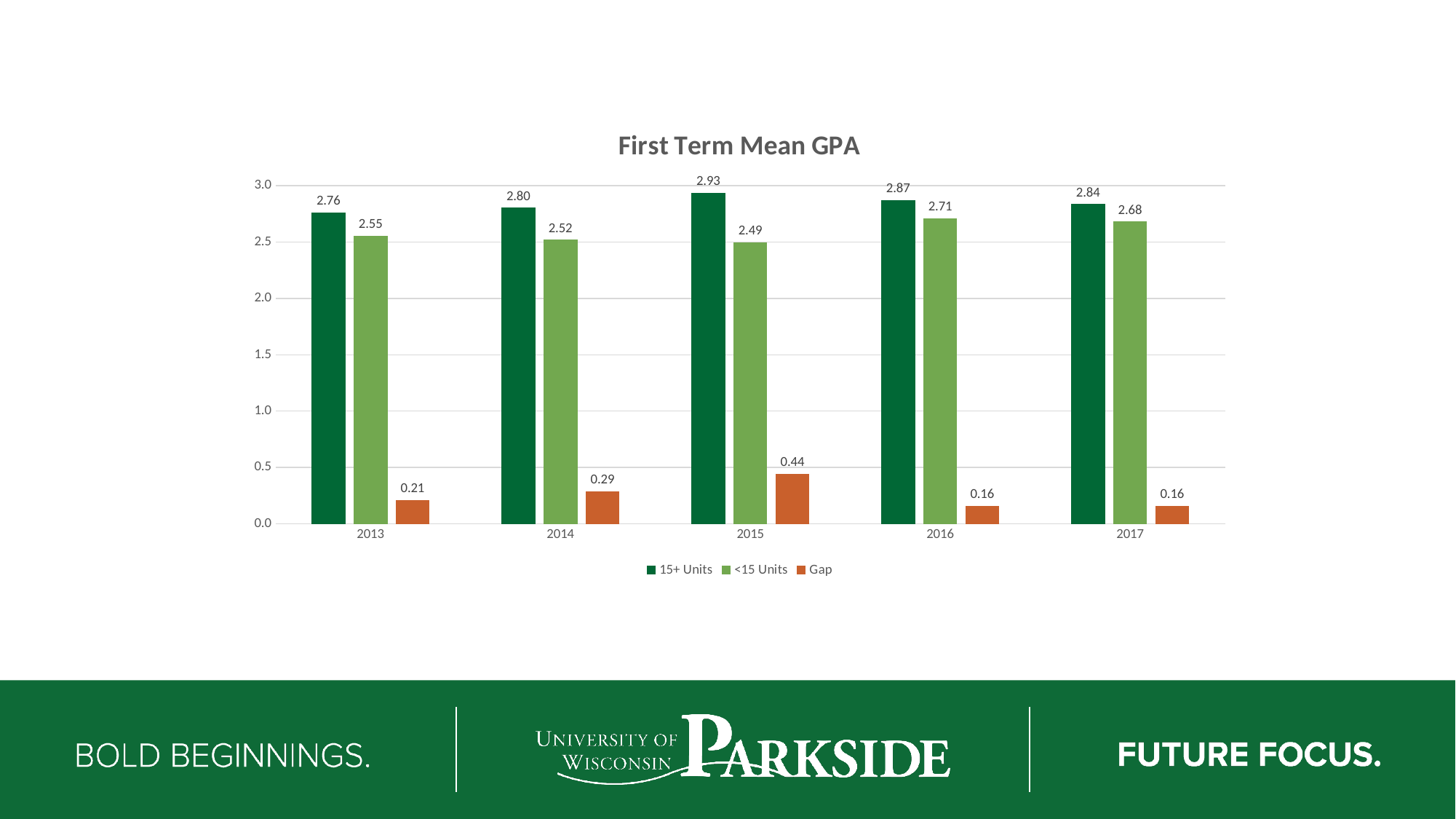
What is the first term mean GPA for 15+ Units in 2015? 2.93 How many series does the legend list? 3 What is the Gap value in 2014? 0.29 In which year is the <15 Units mean GPA lowest? 2015 Which is larger in 2017: the 15+ Units mean GPA or the <15 Units mean GPA? 15+ Units In which year is the 15+ Units mean GPA highest? 2015 In which year is the Gap largest? 2015 What is the title of the chart? First Term Mean GPA What is the difference between the 15+ Units and <15 Units mean GPA in 2016? 0.16 How many years are shown on the x axis? 5 What kind of chart is shown on the slide? Bar chart What is the first term mean GPA for <15 Units in 2013? 2.55